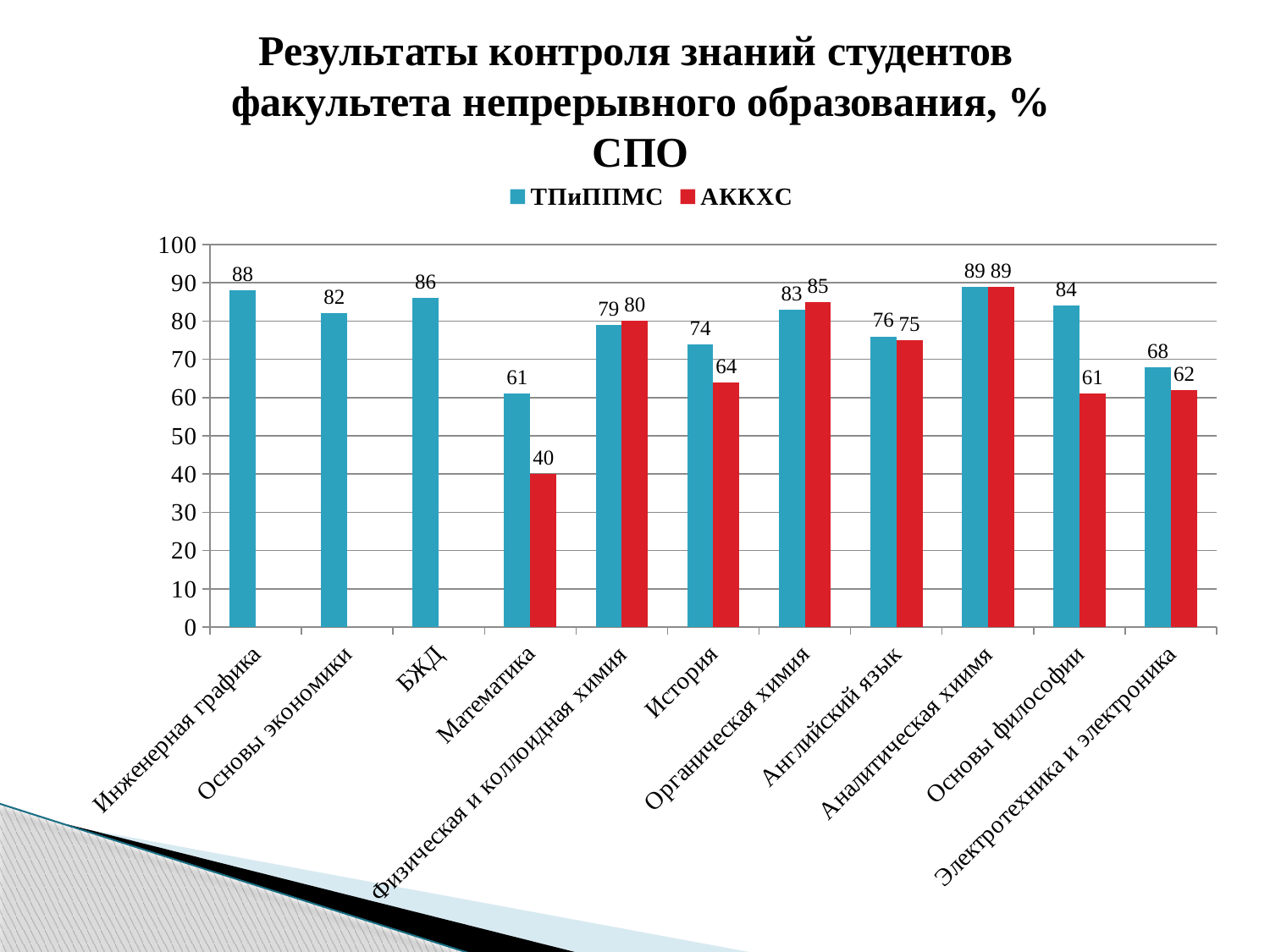
How many categories are shown on the x axis? 11 What is the ТПиППМС value for Математика? 61 Which category has the highest ТПиППМС value? Аналитическая хиимя What is the АККХС value for История? 64 What is the ТПиППМС value for Инженерная графика? 88 Which category has the lowest АККХС value? Математика How many series does the legend list? 2 Which is larger for Органическая химия, the ТПиППМС value or the АККХС value? АККХС What is the АККХС value for Основы философии? 61 What is the difference between the ТПиППМС and АККХС values for Математика? 21 What colour are the АККХС bars? Red What kind of chart is shown on the slide? Bar chart